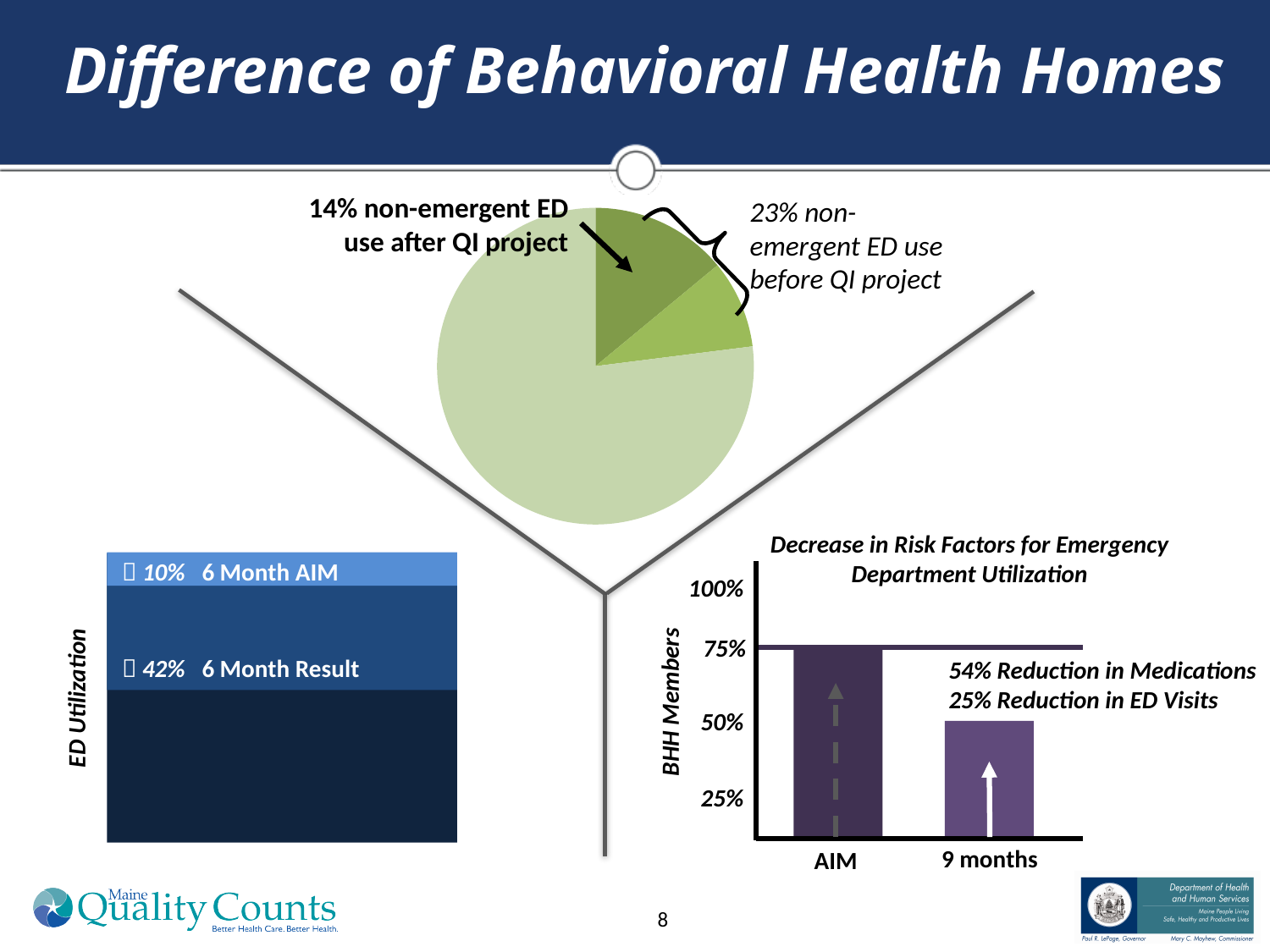
What kind of chart is the bottom-right chart? bar chart In the bottom-right chart, what is the difference between the AIM bar and the 9 months bar? 25% What is the title of the bottom-right chart? Decrease in Risk Factors for Emergency Department Utilization What kind of chart is the top-center chart showing non-emergent ED use? pie chart In the bottom-left ED Utilization chart, what value is shown for 6 Month AIM? 10% What is the y-axis label of the bottom-right chart? BHH Members In the bottom-right chart, what is the value of the AIM bar? 75% In the bottom-right chart, which category has the higher bar, AIM or 9 months? AIM In the bottom-right chart, what is the value of the 9 months bar? 50% In the bottom-left ED Utilization chart, which is larger, the 6 Month AIM or the 6 Month Result? 6 Month Result In the bottom-right chart, how many bars are plotted? 2 In the bottom-left ED Utilization chart, what value is shown for 6 Month Result? 42%